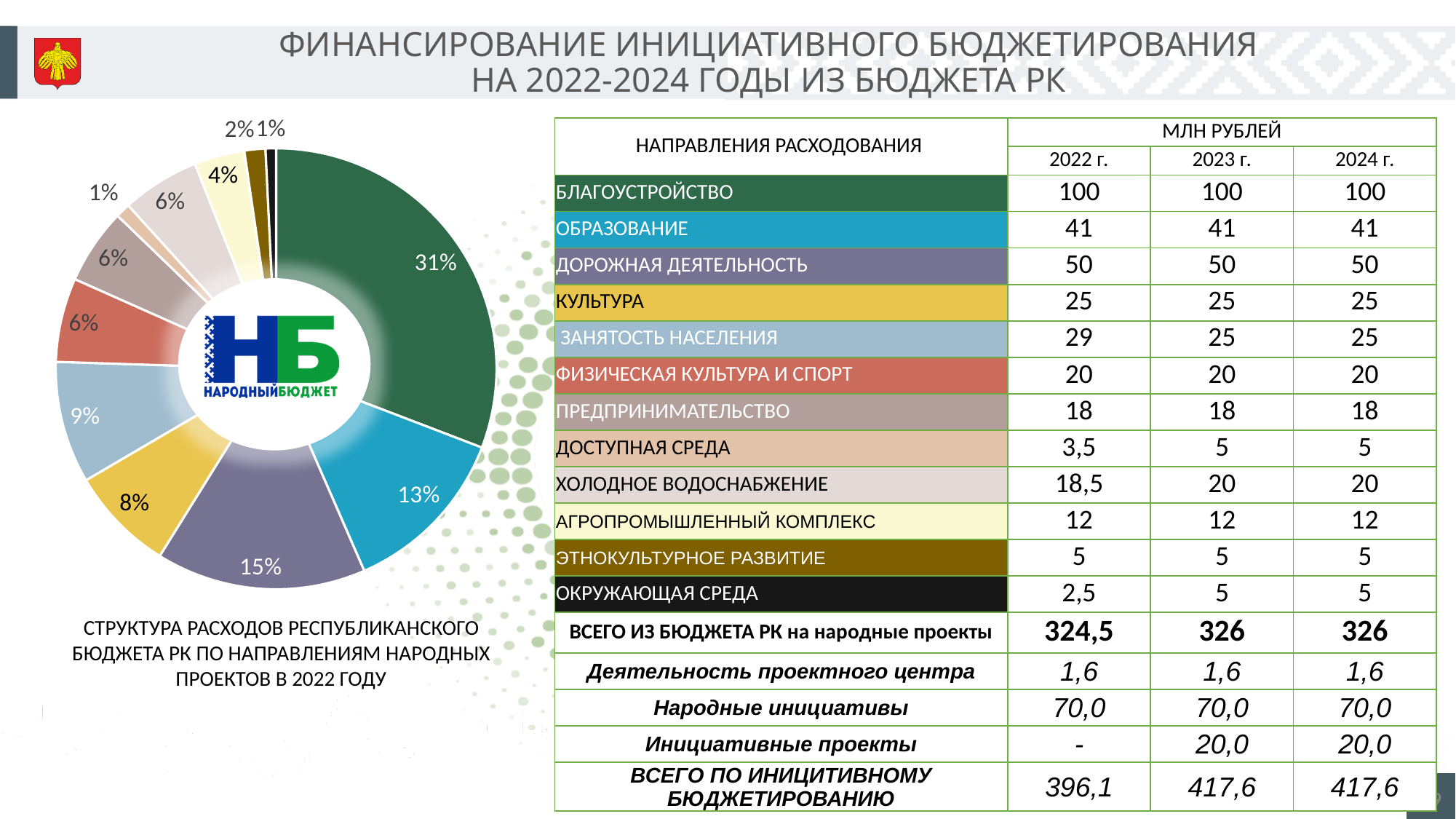
What is the difference in percentage points between the largest slice (31%) and the second largest slice (15%) of the pie chart? 16 What share of the pie chart does the purple slice (Дорожная деятельность) have? 15% Which year does the pie chart's caption say the expense structure refers to? 2022 What share of the pie chart does the light blue slice (Занятость населения) have? 9% What is the largest percentage shown on the pie chart? 31% What kind of chart is shown on the left of the slide? pie chart How many slices does the pie chart have? 12 Which slice of the pie chart is larger: the purple slice (15%) or the blue slice (13%)? the purple slice (15%) What is the smallest percentage shown on the pie chart? 1% What share of the pie chart does the dark green slice (Благоустройство) have? 31%